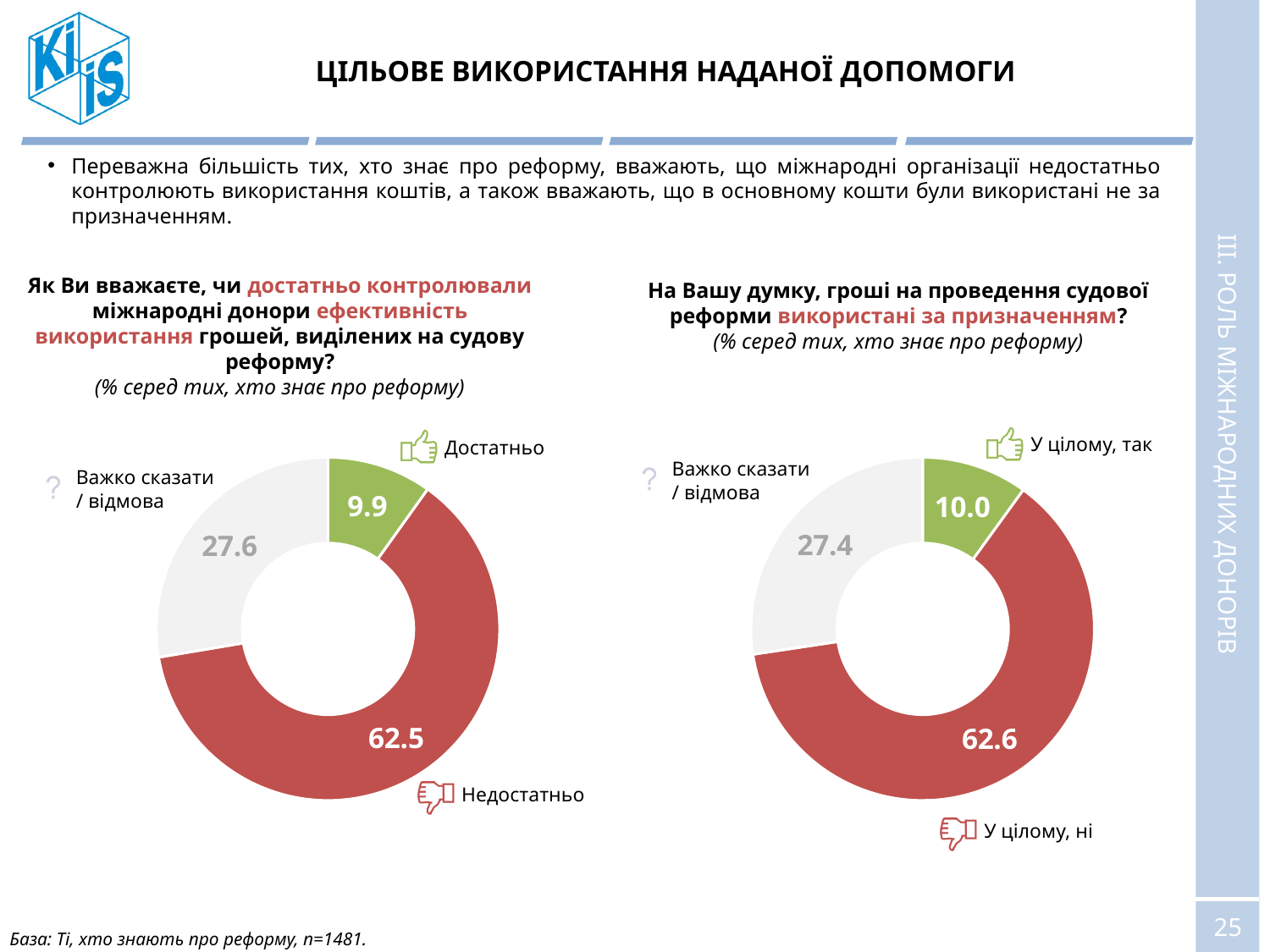
In the left chart, what is the value for "Недостатньо"? 62.5 In the left chart, what is the value for "Достатньо"? 9.9 In the left chart, which category has the highest value? Недостатньо In the left chart, which is larger: "Важко сказати / відмова" or "Достатньо"? Важко сказати / відмова In the right chart, which category has the lowest value? У цілому, так In the right chart, what is the value for "Важко сказати / відмова"? 27.4 In the right chart, what colour is the "У цілому, так" slice? Green How many categories does the right chart show? 3 In the left chart, what is the difference between "Недостатньо" and "Важко сказати / відмова"? 34.9 What type of chart is the left chart? Doughnut chart In the right chart, what is the difference between "У цілому, ні" and "У цілому, так"? 52.6 In the right chart, what is the value for "У цілому, ні"? 62.6